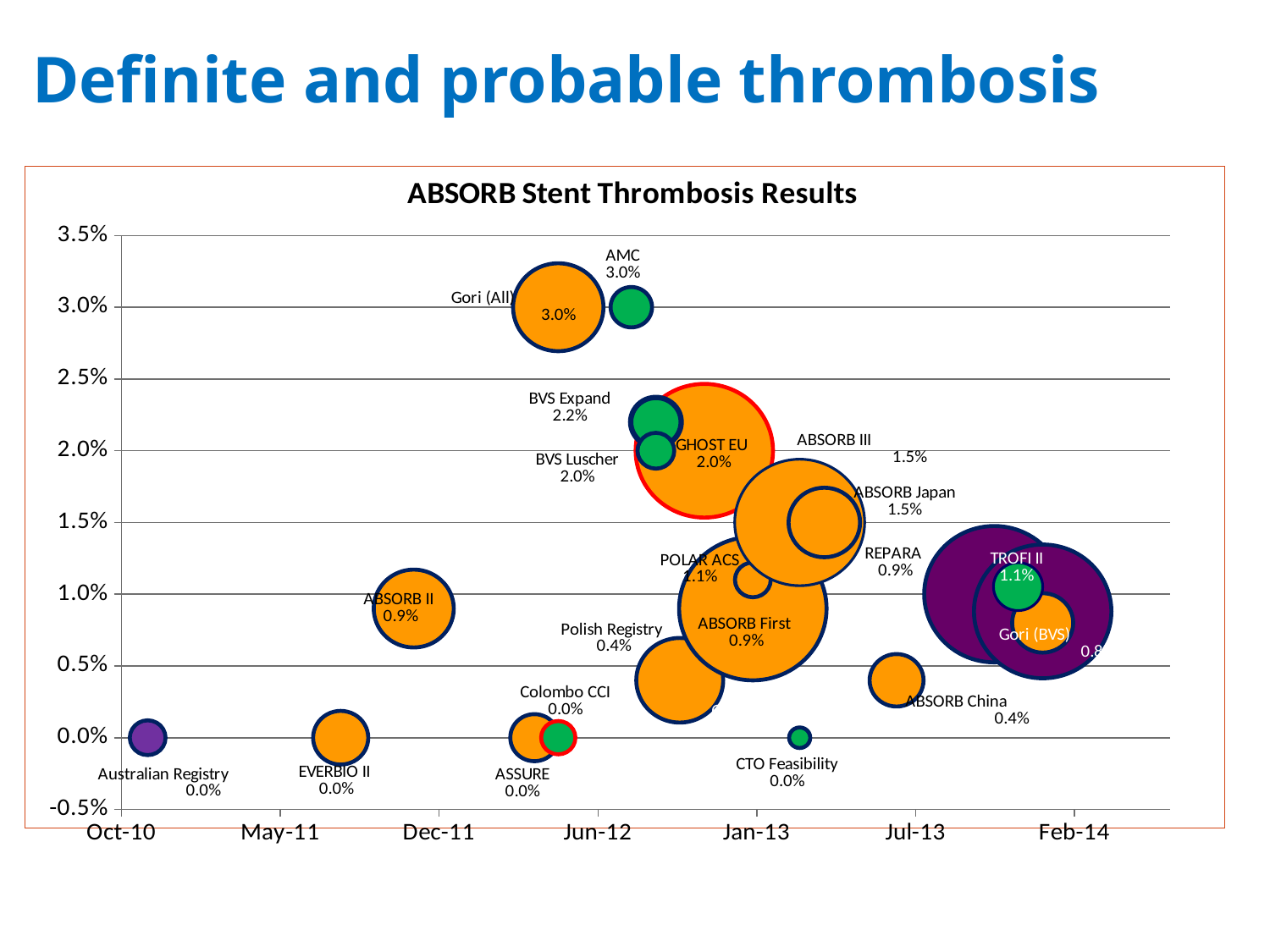
Which has the higher value, ABSORB Japan or REPARA? ABSORB Japan What is the highest thrombosis rate labelled on the chart? 3.0% What is the difference between the values for AMC and TROFI II? 1.9% What is the value labelled for ABSORB II? 0.9% What is the title of the chart? ABSORB Stent Thrombosis Results Is the value for Gori (All) greater or less than 2.5%? greater What is the value labelled for ABSORB China? 0.4% What is the value shown for BVS Expand? 2.2% Which has the higher value, BVS Expand or BVS Luscher? BVS Expand What is the thrombosis rate shown for GHOST EU? 2.0% What is the difference between the values for Gori (All) and ABSORB III? 1.5% What is the value shown for CTO Feasibility? 0.0%